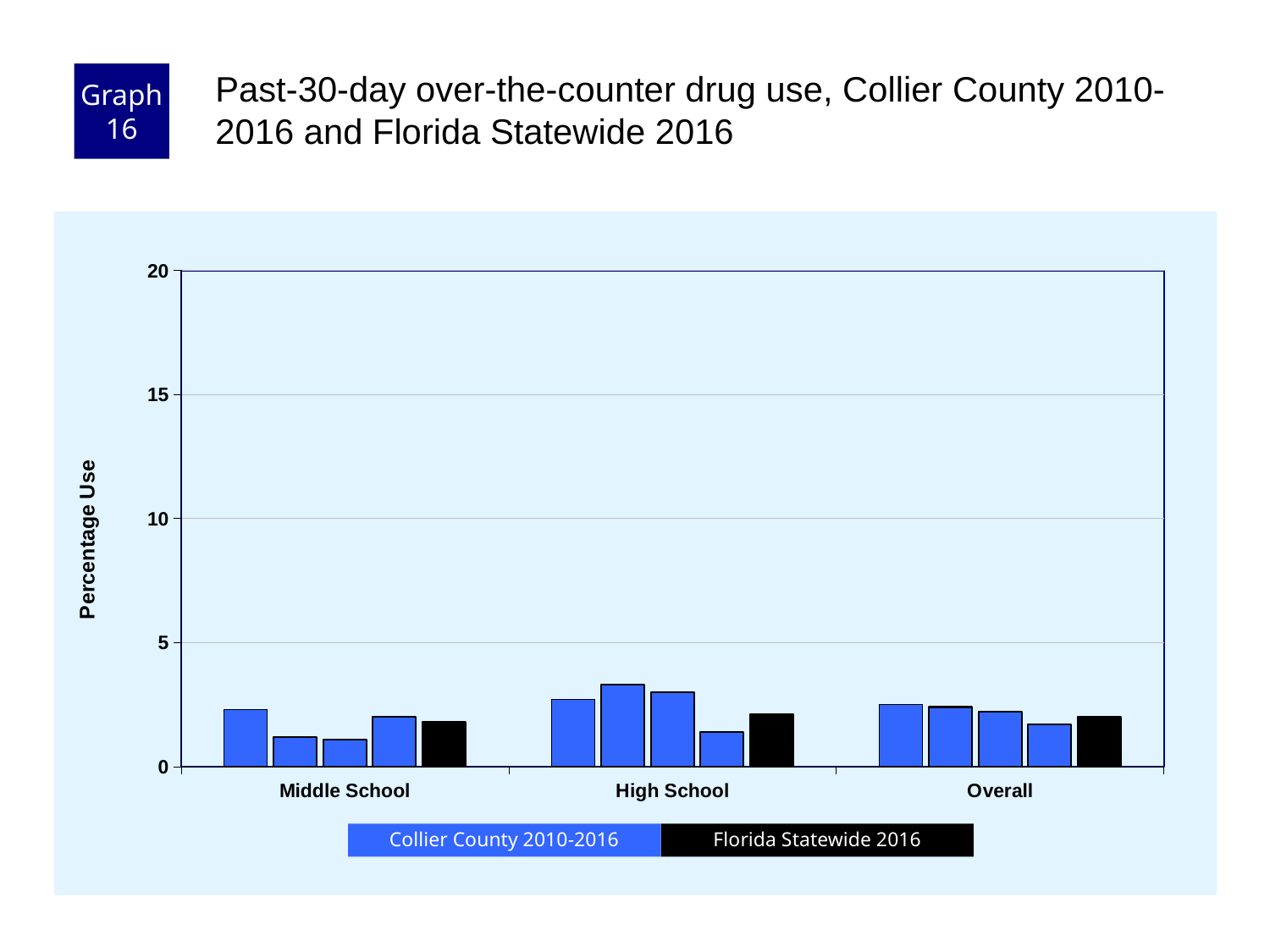
What is the label on the y axis? Percentage Use What kind of chart is shown on the slide? bar chart Is the Florida Statewide 2016 value for High School greater or less than 5? less Which category contains the tallest bar on the chart? High School How many categories are shown along the x axis? 3 Which is larger, the Florida Statewide 2016 value for High School or for Middle School? High School Is the Florida Statewide 2016 value for Middle School greater or less than 5? less How many series does the legend list? 2 Which category contains the shortest bar on the chart? Middle School Is the tallest bar in the High School group greater or less than 5? less What is the title of the chart? Past-30-day over-the-counter drug use, Collier County 2010-2016 and Florida Statewide 2016